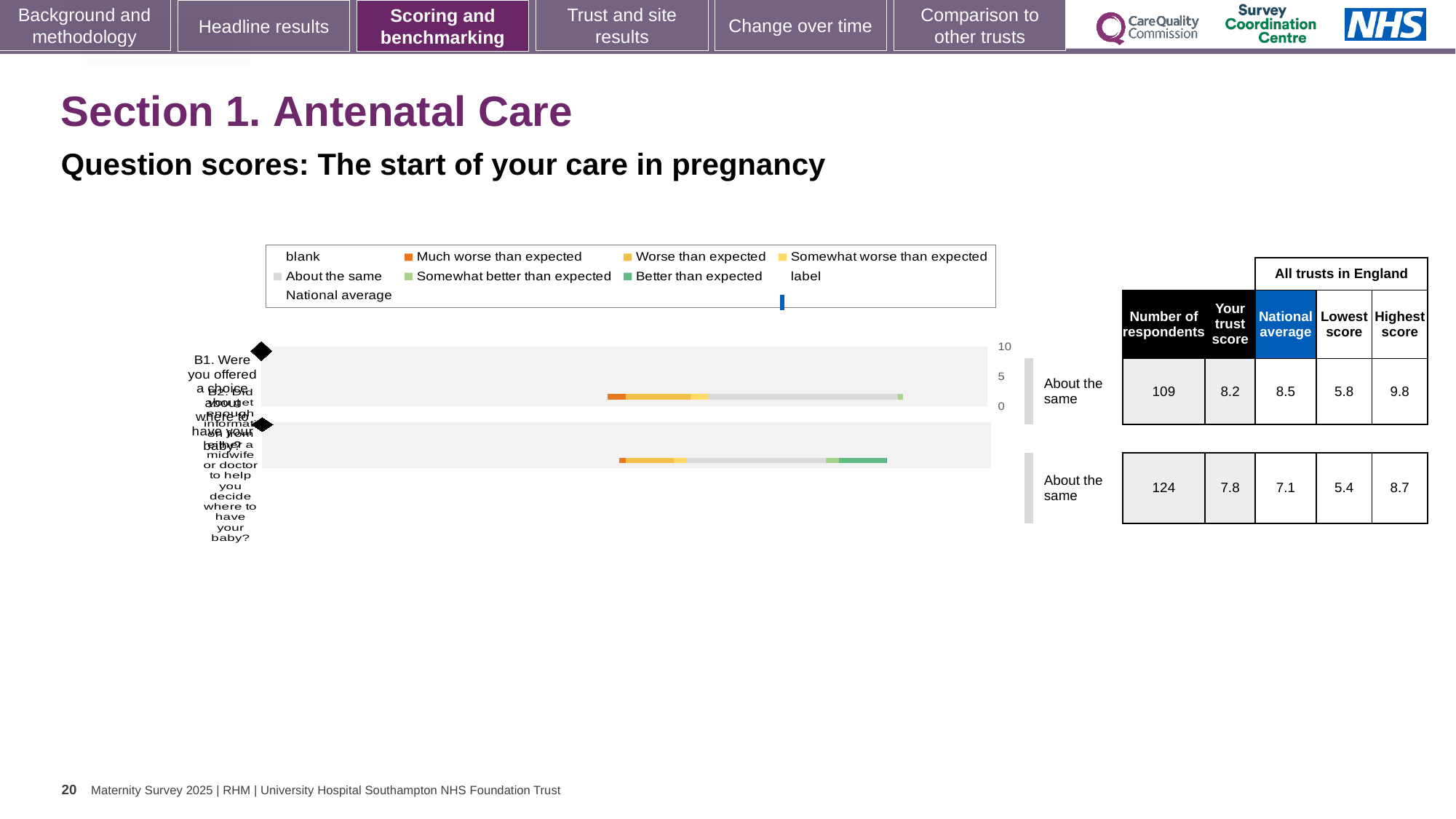
Which row has the higher number of respondents? The second row (B2), with 124 In the table next to the chart, how many respondents are listed for the first row (question B1)? 109 What is the lowest score among all trusts in England for the second row (question B2)? 5.4 For the second row (question B2), which is larger: the trust score or the national average? Your trust score (7.8) How many more respondents does the second row (124) have than the first row (109)? 15 What is 'Your trust score' for the first row (question B1)? 8.2 How many question rows are plotted in the chart? 2 What is the highest score among all trusts in England for the first row (question B1)? 9.8 What kind of chart is shown on the slide? Bar chart What benchmark category is shown beside both bars in the chart? About the same What is the national average for the first row (question B1)? 8.5 What is the difference between the highest score and the lowest score for the first row (question B1)? 4.0